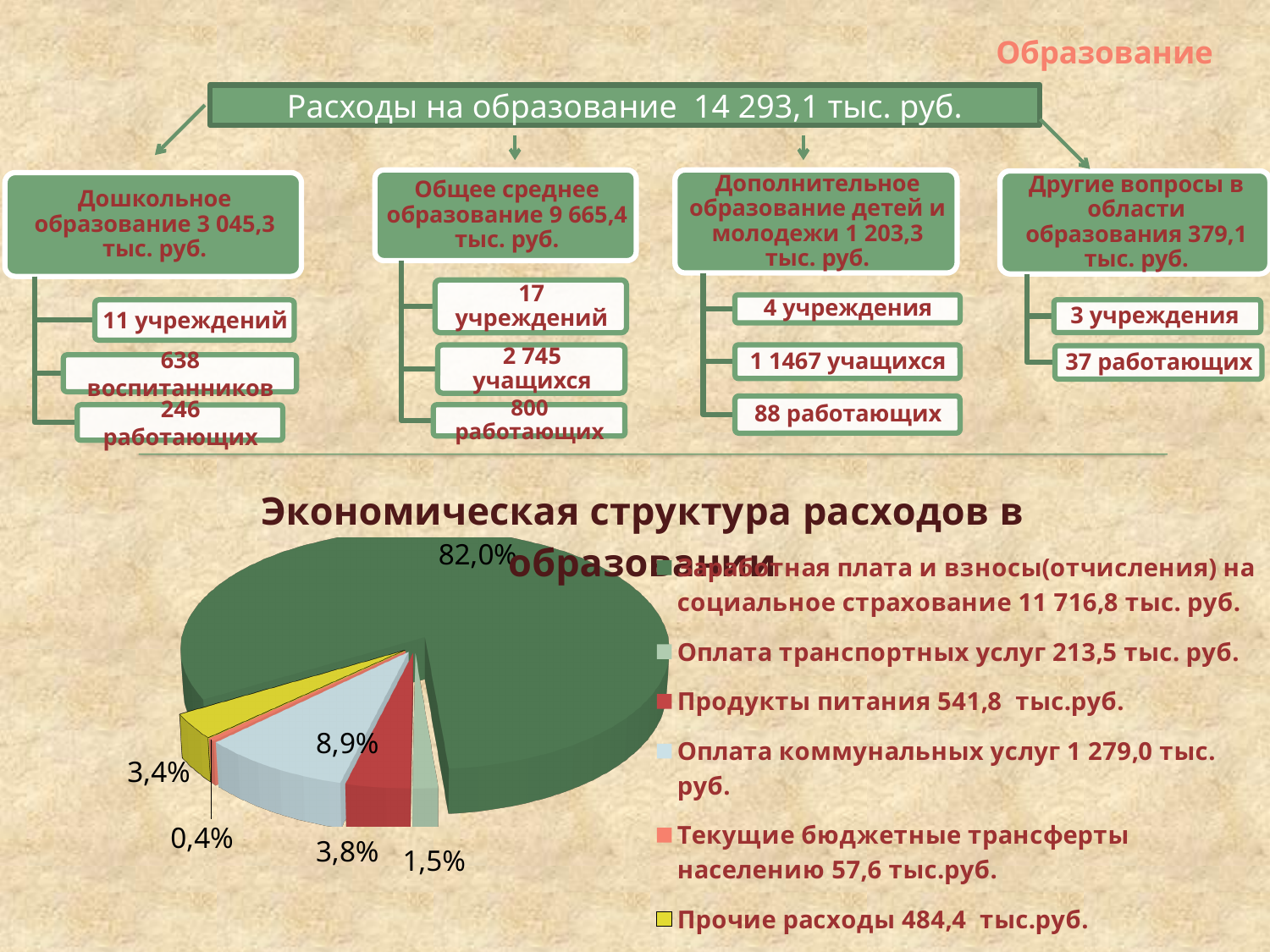
Which category has the largest slice in the pie chart? Заработная плата и взносы(отчисления) на социальное страхование In the pie chart, what share is shown for "Заработная плата и взносы(отчисления) на социальное страхование"? 82,0% How many categories does the legend of the pie chart list? 6 What amount in тыс. руб. does the legend give for "Оплата коммунальных услуг"? 1 279,0 тыс. руб. In the pie chart, what share is shown for "Прочие расходы"? 3,4% In the pie chart, what share is shown for "Продукты питания"? 3,8% Which is larger in the pie chart: the share for "Продукты питания" or the share for "Прочие расходы"? Продукты питания Which category has the smallest slice in the pie chart? Текущие бюджетные трансферты населению What kind of chart is shown under the title "Экономическая структура расходов в образовании"? pie chart